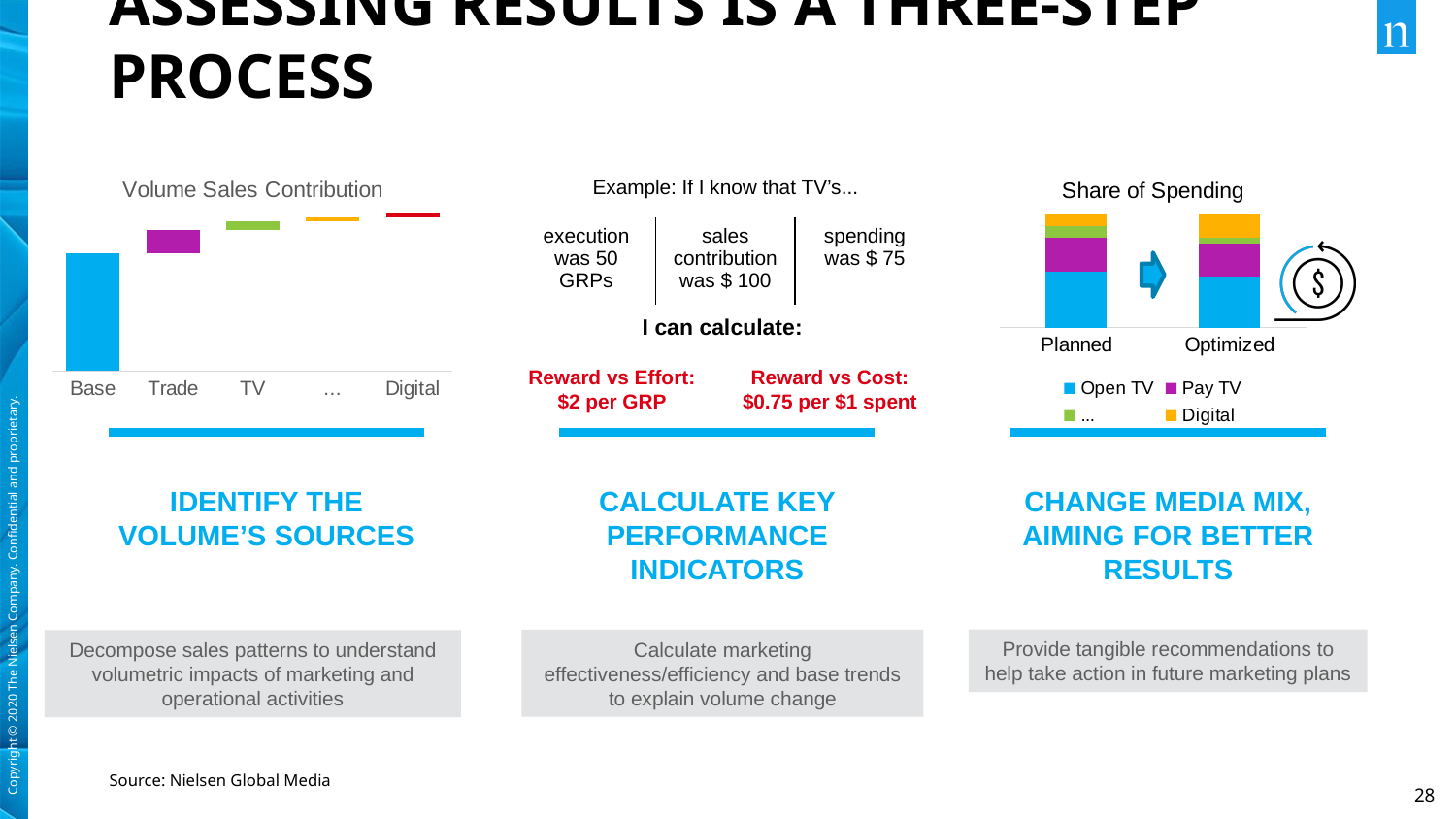
In the "Volume Sales Contribution" chart, which category has the tallest bar? Base How many bars are shown in the "Share of Spending" chart? 2 What are the two category labels on the x axis of the "Share of Spending" chart? Planned and Optimized What is the first category label on the x axis of the "Volume Sales Contribution" chart? Base What kind of chart is the "Share of Spending" chart? stacked bar chart In the "Share of Spending" chart, is the Digital segment larger in the Planned bar or the Optimized bar? Optimized How many categories are shown on the x axis of the "Volume Sales Contribution" chart? 5 What kind of chart is the "Volume Sales Contribution" chart? bar chart In the "Volume Sales Contribution" chart, which bar is larger, Base or Trade? Base What is the last category label on the x axis of the "Volume Sales Contribution" chart? Digital In the "Share of Spending" chart, which series occupies the largest segment of the Planned bar? Open TV How many series does the legend of the "Share of Spending" chart list? 4